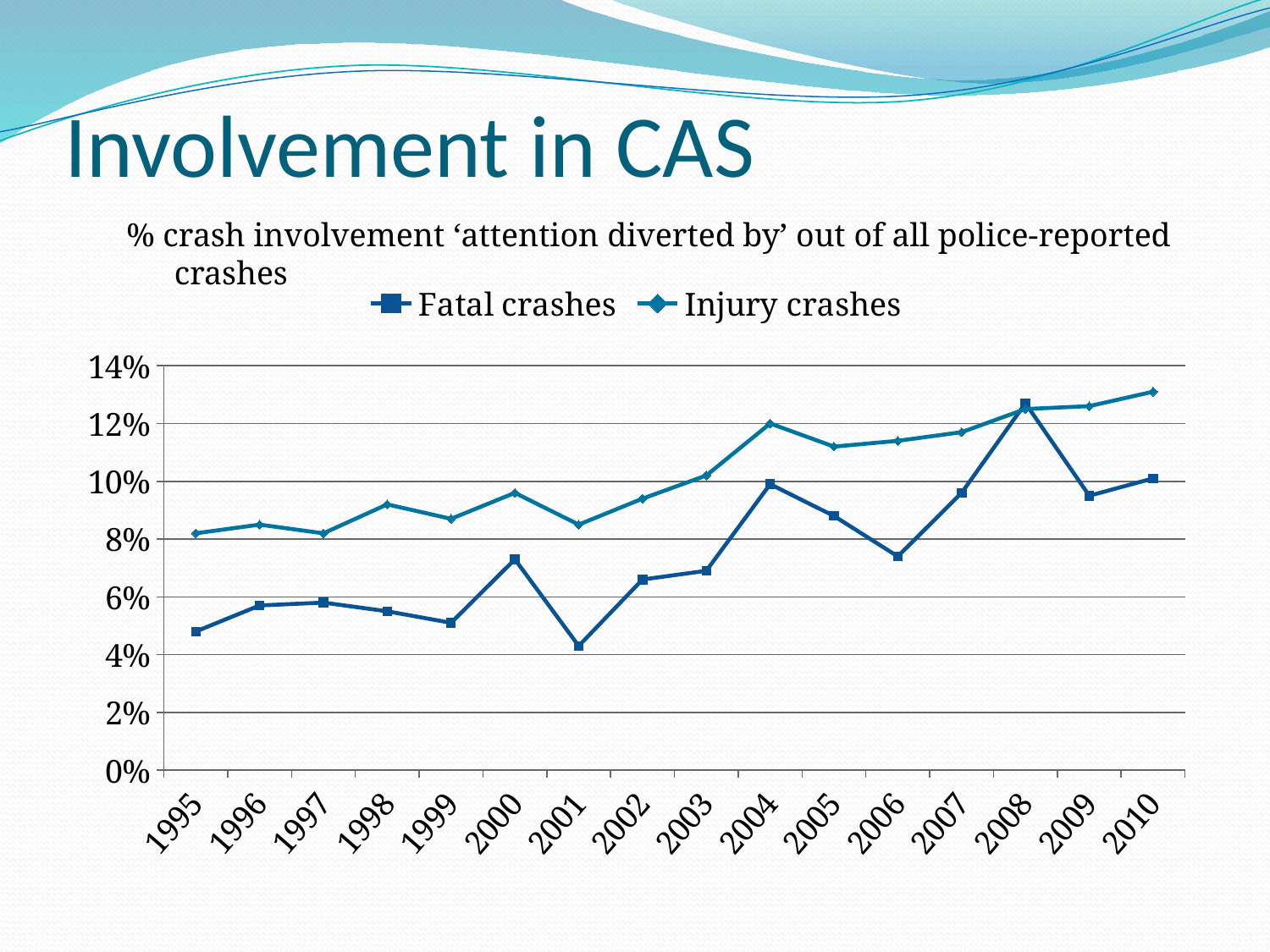
Is the Injury crashes value for 2010 greater or less than 12%? greater In which year is the Fatal crashes value lowest? 2001 Is the Fatal crashes value for 2001 greater or less than 6%? less In which year is the Fatal crashes value highest? 2008 In 2001, which series has the larger value, Fatal crashes or Injury crashes? Injury crashes How many series does the legend list? 2 How many years are plotted along the x axis? 16 In which year is the Injury crashes value highest? 2010 What kind of chart is shown on the slide? Line chart Overall, do the Injury crashes values rise or fall from 1995 to 2010? Rise Is the Fatal crashes value for 2008 greater or less than 10%? greater What are the two series named in the legend? Fatal crashes and Injury crashes